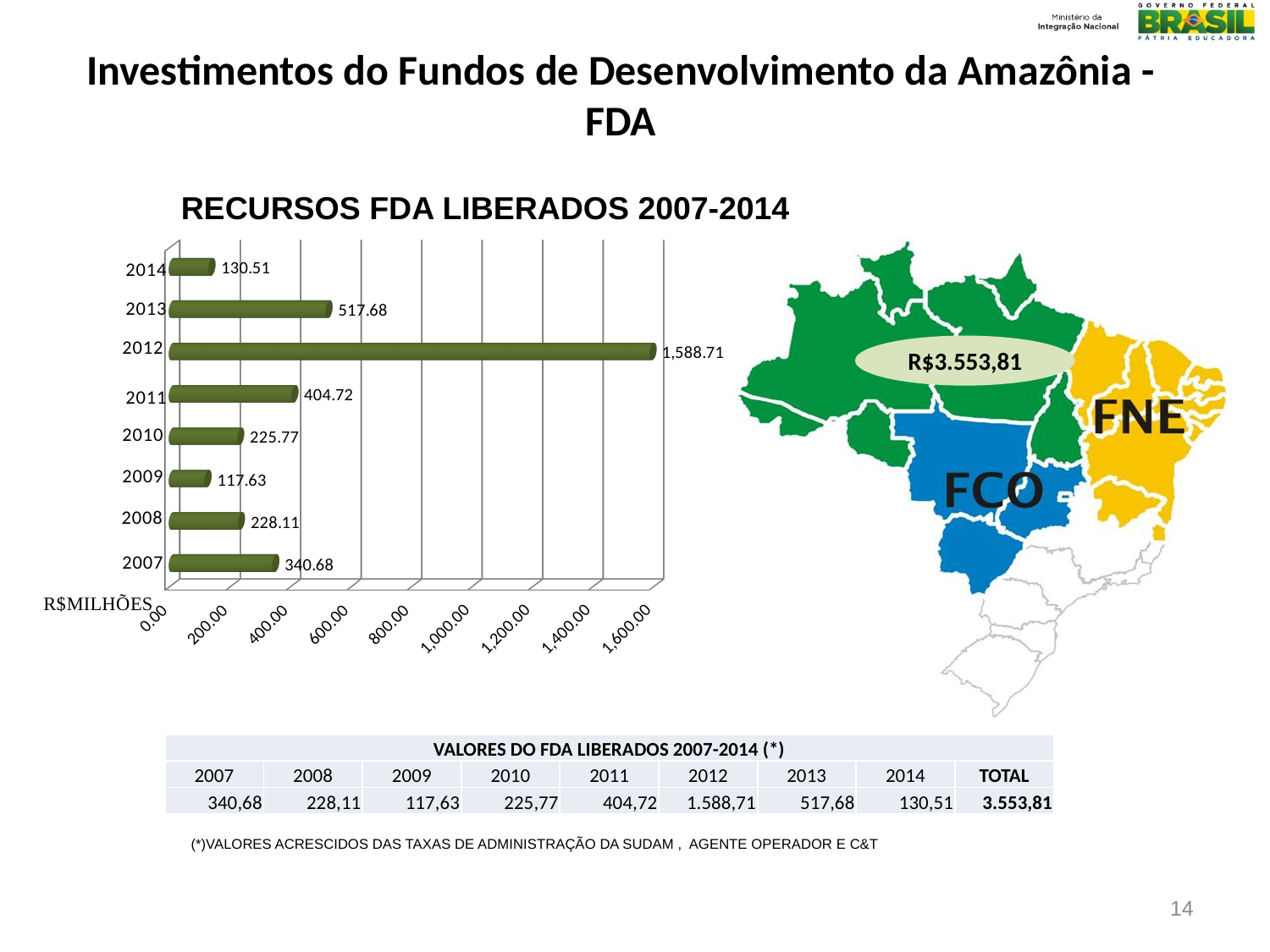
What is the difference between the values for 2012 and 2013? 1,071.03 What is the value for 2009 in the chart? 117.63 What is the value for 2014 in the chart? 130.51 What is the value for 2012 in the chart? 1,588.71 How many years are plotted in the chart? 8 What is the value for 2007 in the chart? 340.68 What is the title of the chart? RECURSOS FDA LIBERADOS 2007-2014 What type of chart is shown on the slide? bar chart Which is larger, the value for 2011 or the value for 2007? 2011 Do the values rise or fall from 2012 to 2014? fall Which year has the highest value in the chart? 2012 Which year has the lowest value in the chart? 2009